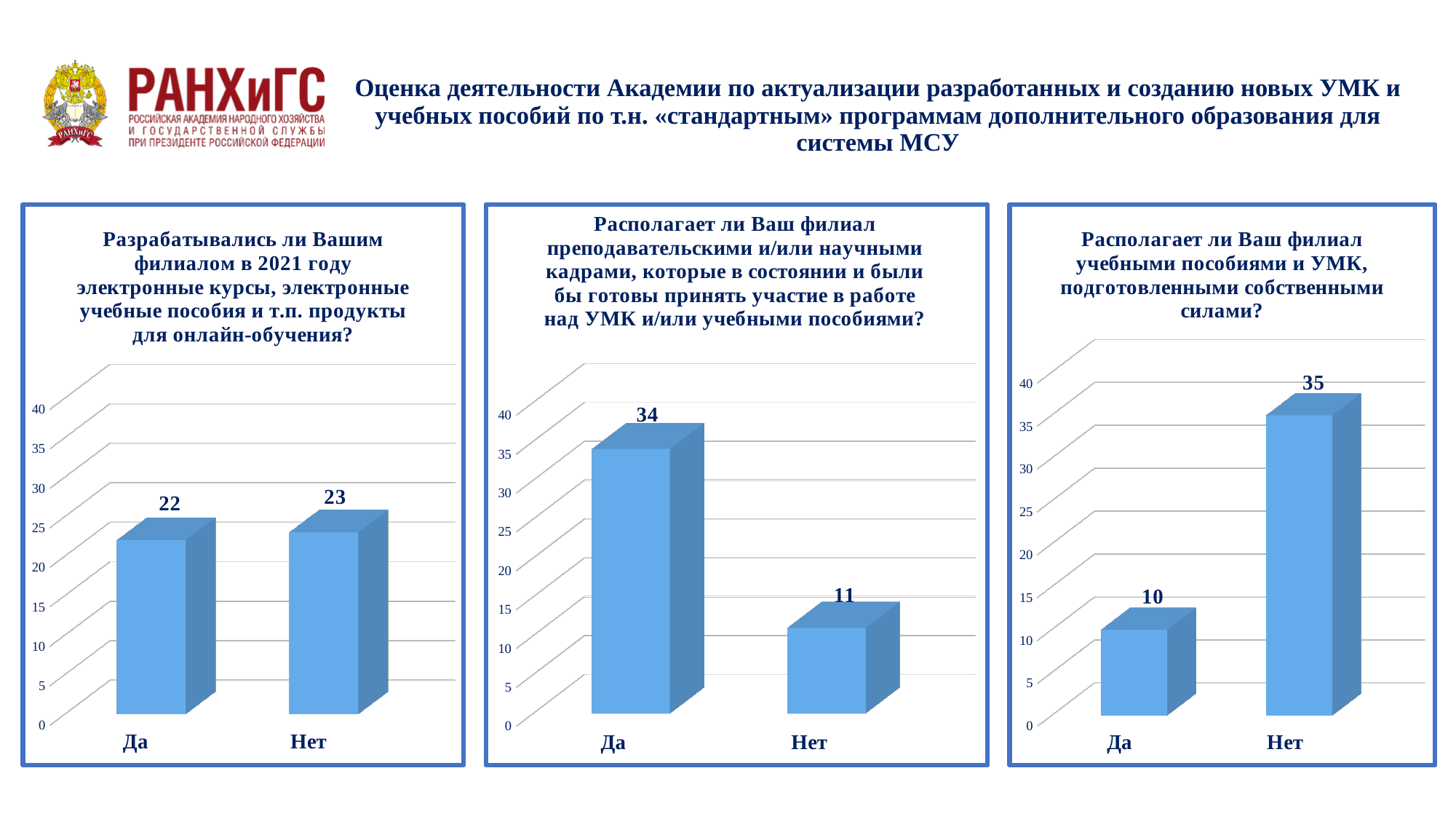
In the middle chart (Располагает ли Ваш филиал преподавательскими и/или научными кадрами...), what is the value for Да? 34 In the left chart (Разрабатывались ли Вашим филиалом в 2021 году электронные курсы...), what is the value for Нет? 23 In the right chart (Располагает ли Ваш филиал учебными пособиями и УМК, подготовленными собственными силами?), which category has the highest value? Нет In the middle chart (Располагает ли Ваш филиал преподавательскими и/или научными кадрами...), which category has the lowest value? Нет In the middle chart (Располагает ли Ваш филиал преподавательскими и/или научными кадрами...), what is the difference between the values for Да and Нет? 23 How many categories does the left chart (Разрабатывались ли Вашим филиалом в 2021 году электронные курсы...) show? 2 In the middle chart (Располагает ли Ваш филиал преподавательскими и/или научными кадрами...), what is the value for Нет? 11 In the left chart (Разрабатывались ли Вашим филиалом в 2021 году электронные курсы...), what is the difference between the values for Нет and Да? 1 In the right chart (Располагает ли Ваш филиал учебными пособиями и УМК, подготовленными собственными силами?), what is the value for Да? 10 What kind of chart is the right chart (Располагает ли Ваш филиал учебными пособиями и УМК, подготовленными собственными силами?)? Bar chart In the left chart (Разрабатывались ли Вашим филиалом в 2021 году электронные курсы...), what is the value for Да? 22 In the right chart (Располагает ли Ваш филиал учебными пособиями и УМК, подготовленными собственными силами?), what is the difference between the values for Нет and Да? 25